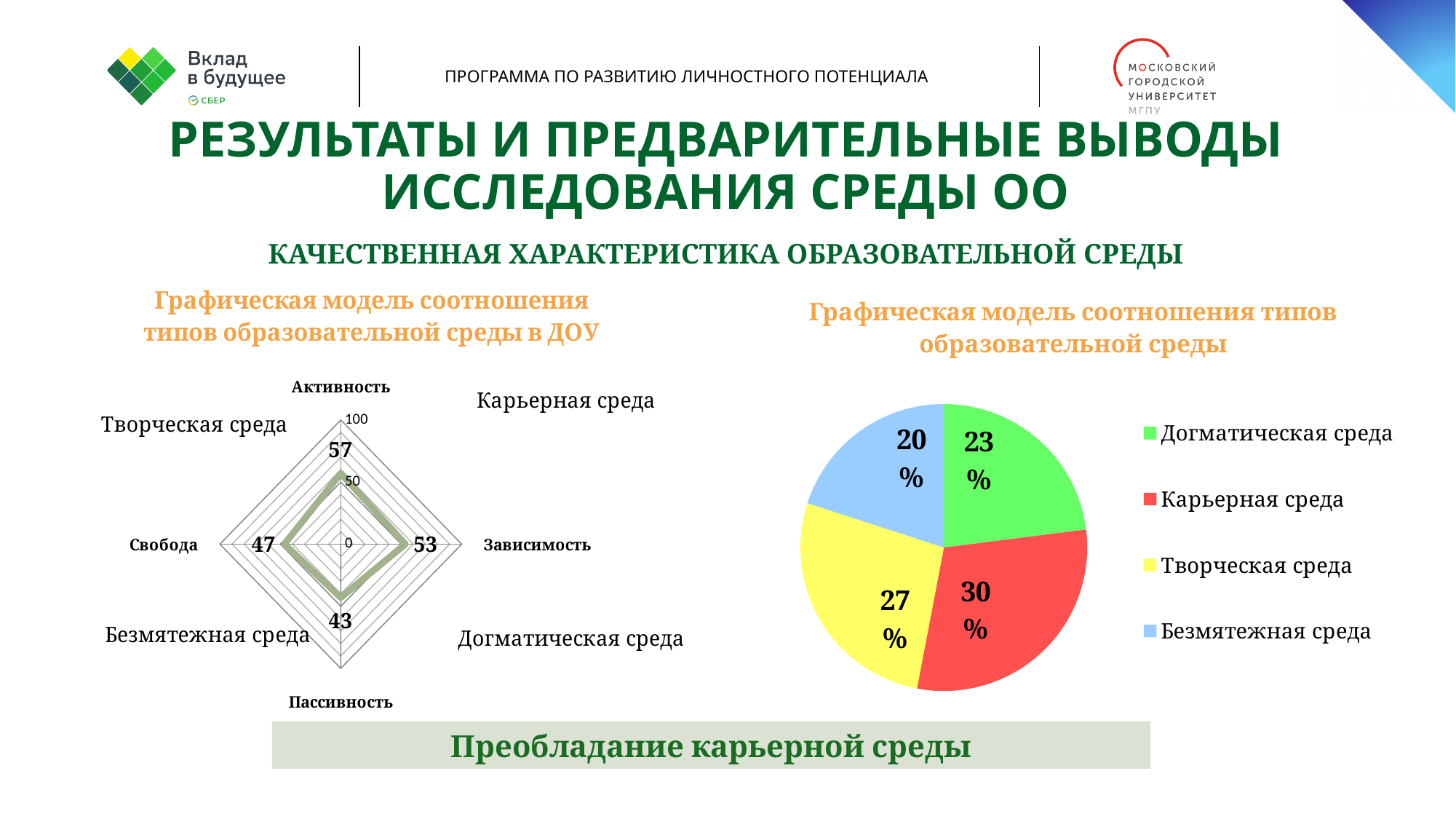
In the pie chart on the right, which is larger: Творческая среда or Догматическая среда? Творческая среда In the radar chart on the left, which axis has the highest value? Активность In the pie chart on the right, which category has the smallest share? Безмятежная среда What kind of chart is the chart on the right? Pie chart In the pie chart on the right, what share does Карьерная среда have? 30% In the radar chart on the left, what is the value for Пассивность? 43 In the pie chart on the right, which category has the largest share? Карьерная среда How many categories does the legend of the pie chart on the right list? 4 In the pie chart on the right, what is the difference between the shares of Карьерная среда and Догматическая среда? 7% In the radar chart on the left, what is the difference between the values for Зависимость and Свобода? 6 In the radar chart on the left, what is the value for Активность? 57 In the pie chart on the right, what share does Безмятежная среда have? 20%